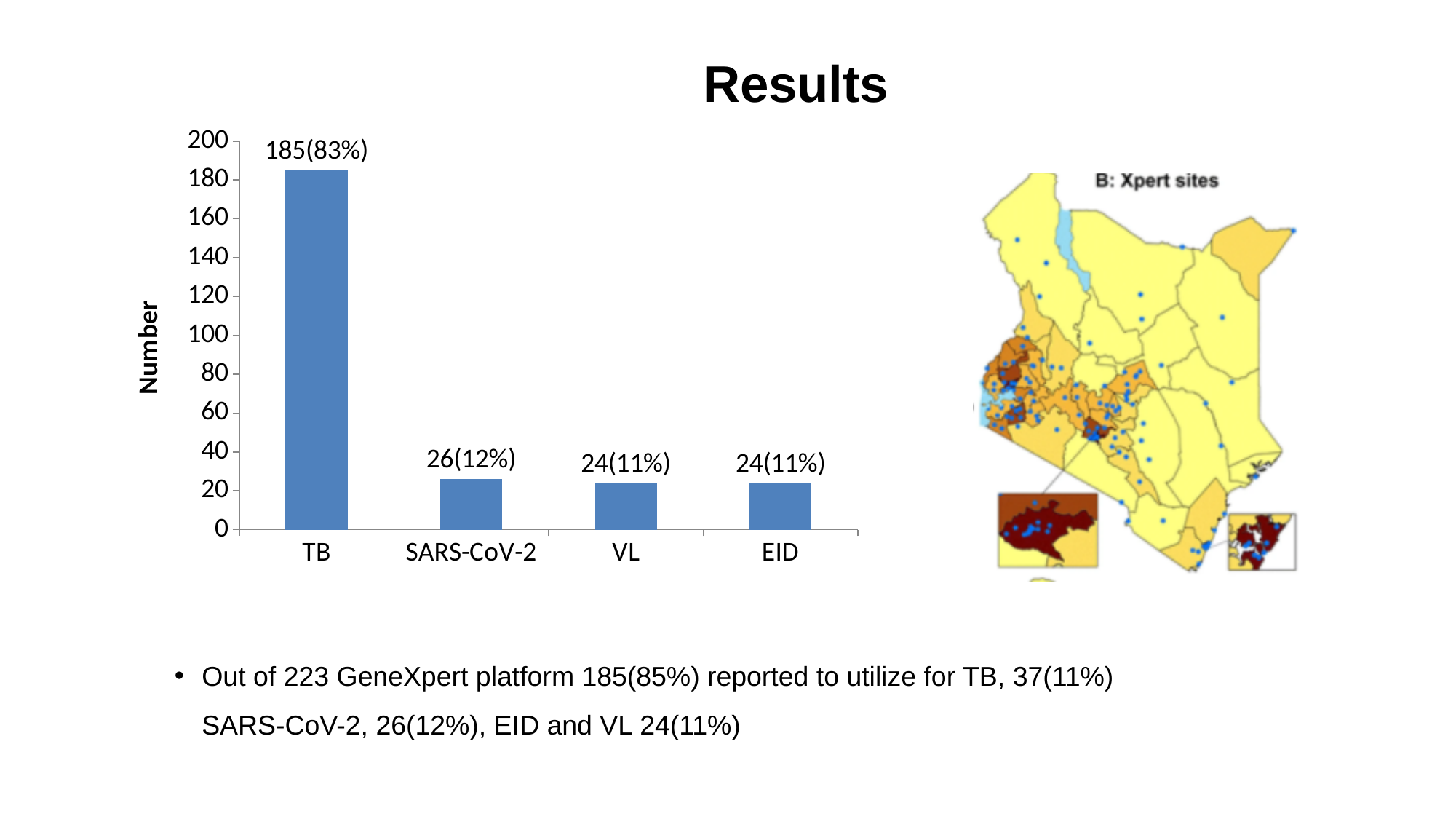
What kind of chart is shown on the left of the slide? bar chart How many categories are shown on the x axis of the bar chart? 4 Is the value for TB in the bar chart greater or less than 100? greater What is the difference between the TB count and the SARS-CoV-2 count in the bar chart? 159 What is the data label shown for TB in the bar chart? 185(83%) What is the data label shown for VL in the bar chart? 24(11%) Which is larger in the bar chart, the value for TB or the value for SARS-CoV-2? TB What is the label of the vertical axis of the bar chart? Number Which category has the highest value in the bar chart? TB What is the data label shown for SARS-CoV-2 in the bar chart? 26(12%) What is the difference between the SARS-CoV-2 count and the VL count in the bar chart? 2 What is the data label shown for EID in the bar chart? 24(11%)